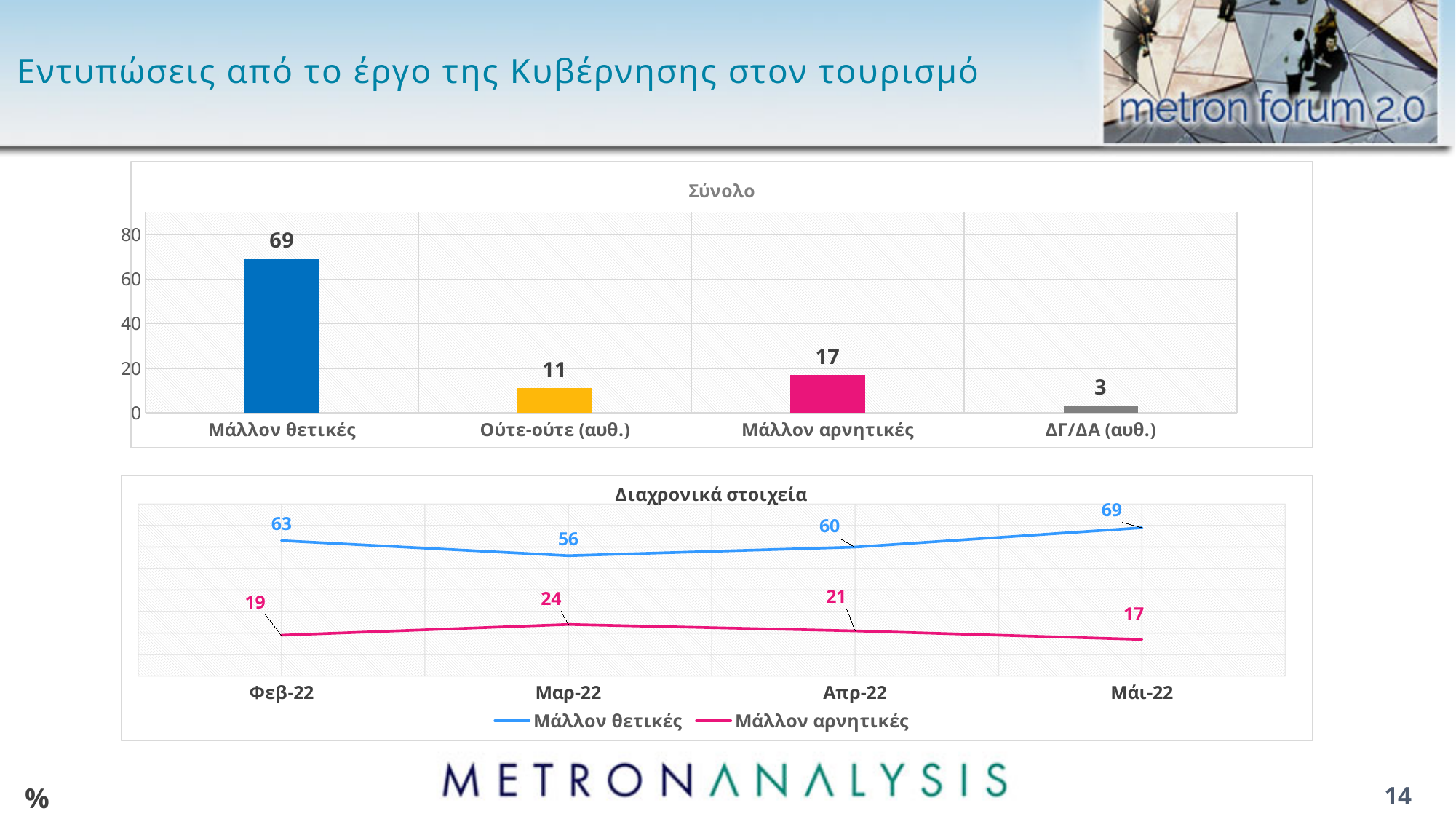
In the 'Διαχρονικά στοιχεία' chart, does 'Μάλλον θετικές' rise or fall from Μαρ-22 to Μάι-22? Rise In the 'Διαχρονικά στοιχεία' chart, what is the value for 'Μάλλον θετικές' in Μαρ-22? 56 In the 'Σύνολο' chart, what is the difference between 'Μάλλον θετικές' and 'Μάλλον αρνητικές'? 52 In the 'Διαχρονικά στοιχεία' chart, how many series does the legend list? 2 In the 'Διαχρονικά στοιχεία' chart, what is the difference between 'Μάλλον θετικές' and 'Μάλλον αρνητικές' in Φεβ-22? 44 In the 'Σύνολο' chart, which category has the lowest value? ΔΓ/ΔΑ (αυθ.) In the 'Διαχρονικά στοιχεία' chart, what is the value for 'Μάλλον αρνητικές' in Απρ-22? 21 In the 'Σύνολο' chart, what is the value for 'Μάλλον θετικές'? 69 In the 'Διαχρονικά στοιχεία' chart, in which month is 'Μάλλον αρνητικές' highest? Μαρ-22 In the 'Σύνολο' chart, how many categories are shown? 4 What kind of chart is the 'Σύνολο' chart? Bar chart In the 'Σύνολο' chart, what is the value for 'Ούτε-ούτε (αυθ.)'? 11